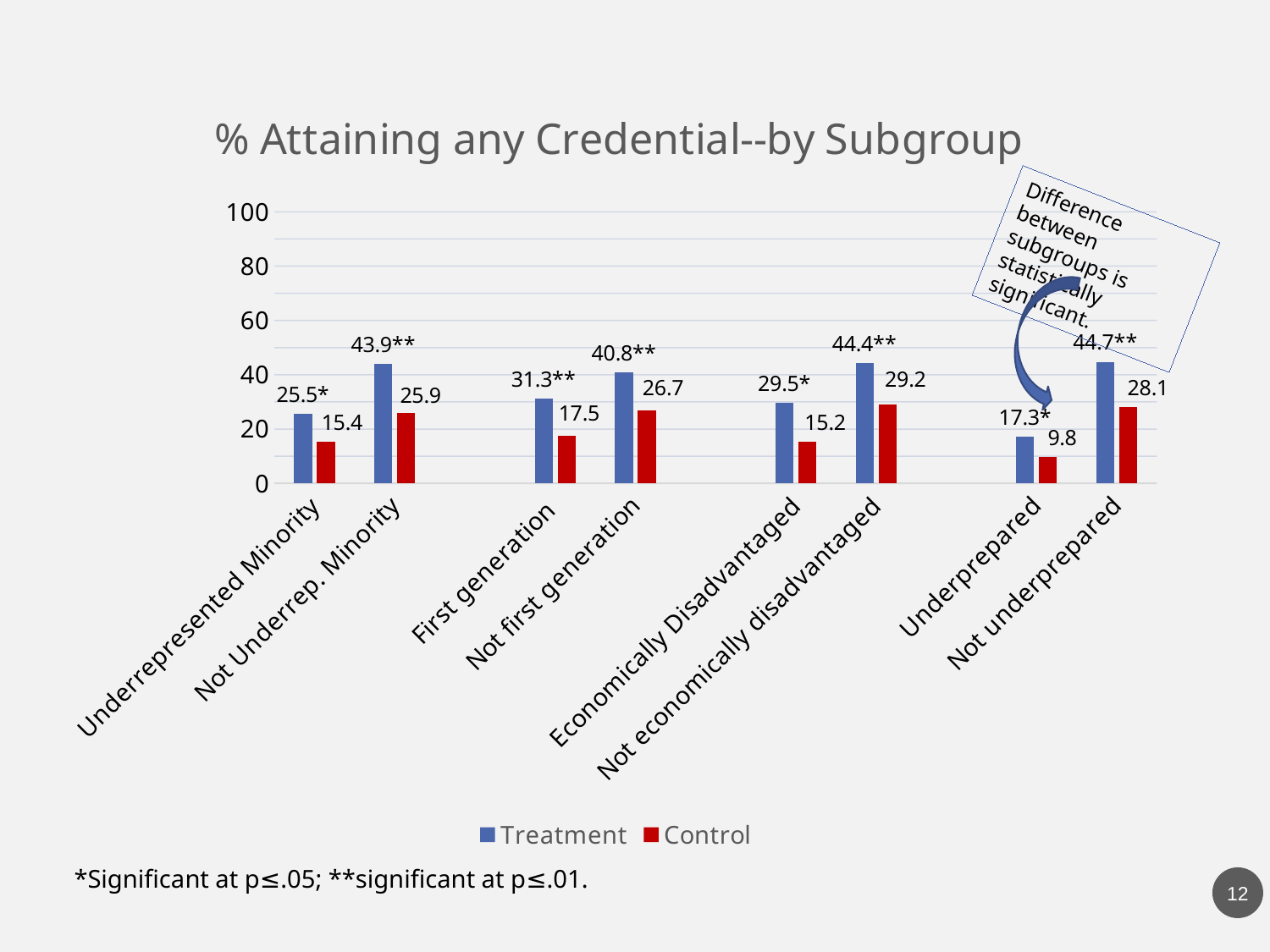
How many subgroups are shown on the x axis? 8 What is the Treatment value for Economically Disadvantaged? 29.5* What is the Treatment value for Not Underrep. Minority? 43.9** How many series does the legend list? 2 What is the difference between the Treatment and Control values for Underrepresented Minority? 10.1 Which subgroup has the highest Treatment value? Not underprepared What is the Control value for Underprepared? 9.8 Which subgroup has the lowest Control value? Underprepared What is the difference between the Treatment and Control values for Not underprepared? 16.6 What is the Control value for Not first generation? 26.7 What kind of chart is shown on the slide? Bar chart Which is larger, the Control value for First generation or the Control value for Not first generation? Not first generation